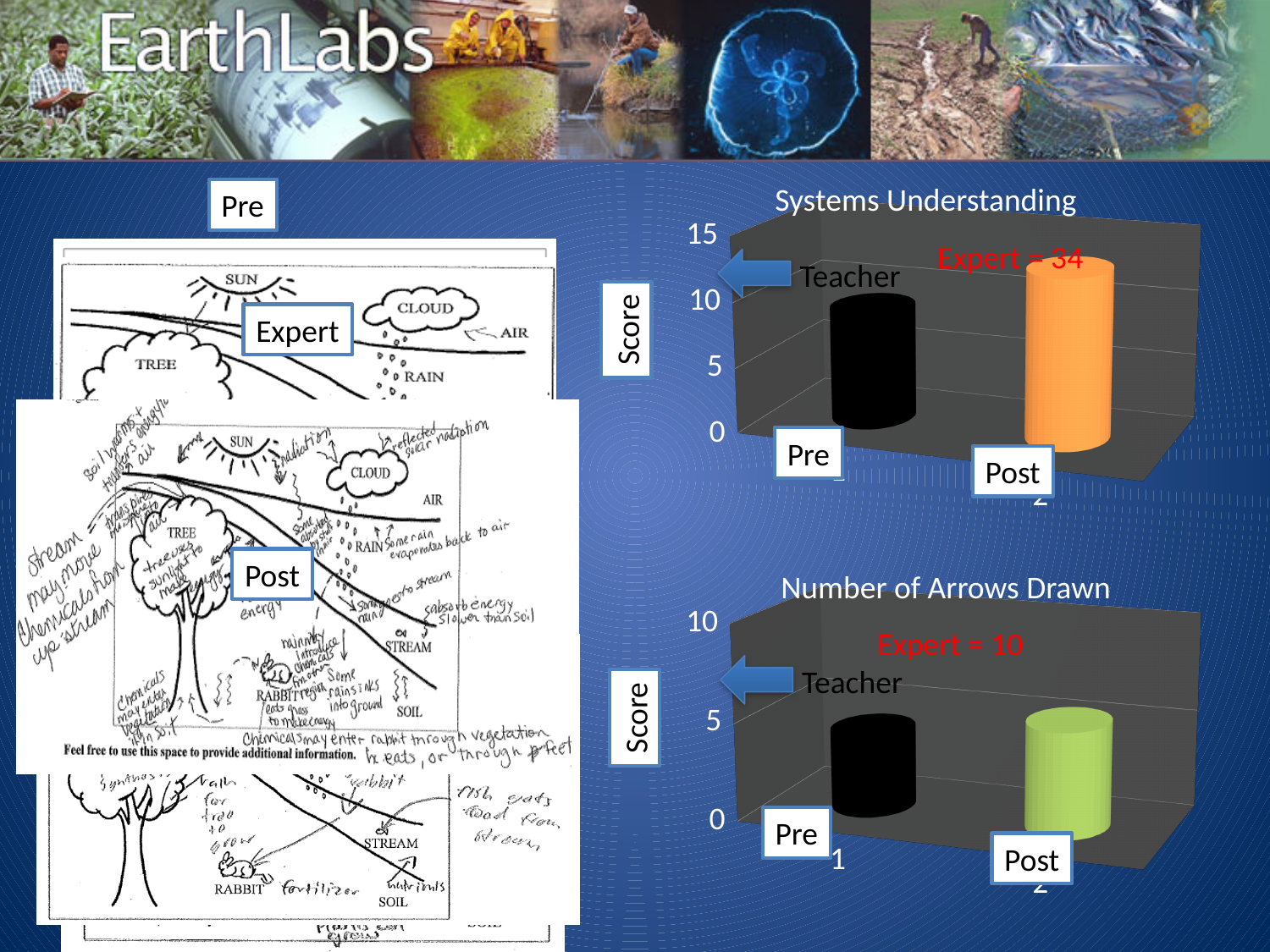
What expert value is annotated on the 'Systems Understanding' chart? Expert = 34 In the 'Systems Understanding' chart, which category has the higher score, Pre or Post? Post In the 'Number of Arrows Drawn' chart, is the value for Pre greater or less than 10? less In the 'Systems Understanding' chart, which category has the highest score? Post In the 'Systems Understanding' chart, how many categories are plotted? 2 In the 'Number of Arrows Drawn' chart, is the value for Post greater or less than 10? less What expert value is annotated on the 'Number of Arrows Drawn' chart? Expert = 10 In the 'Systems Understanding' chart, is the value for Post greater or less than 10? greater In the 'Systems Understanding' chart, does the score rise or fall from Pre to Post? rise In the 'Number of Arrows Drawn' chart, how many categories are plotted? 2 What kind of chart is the 'Systems Understanding' chart? Bar chart